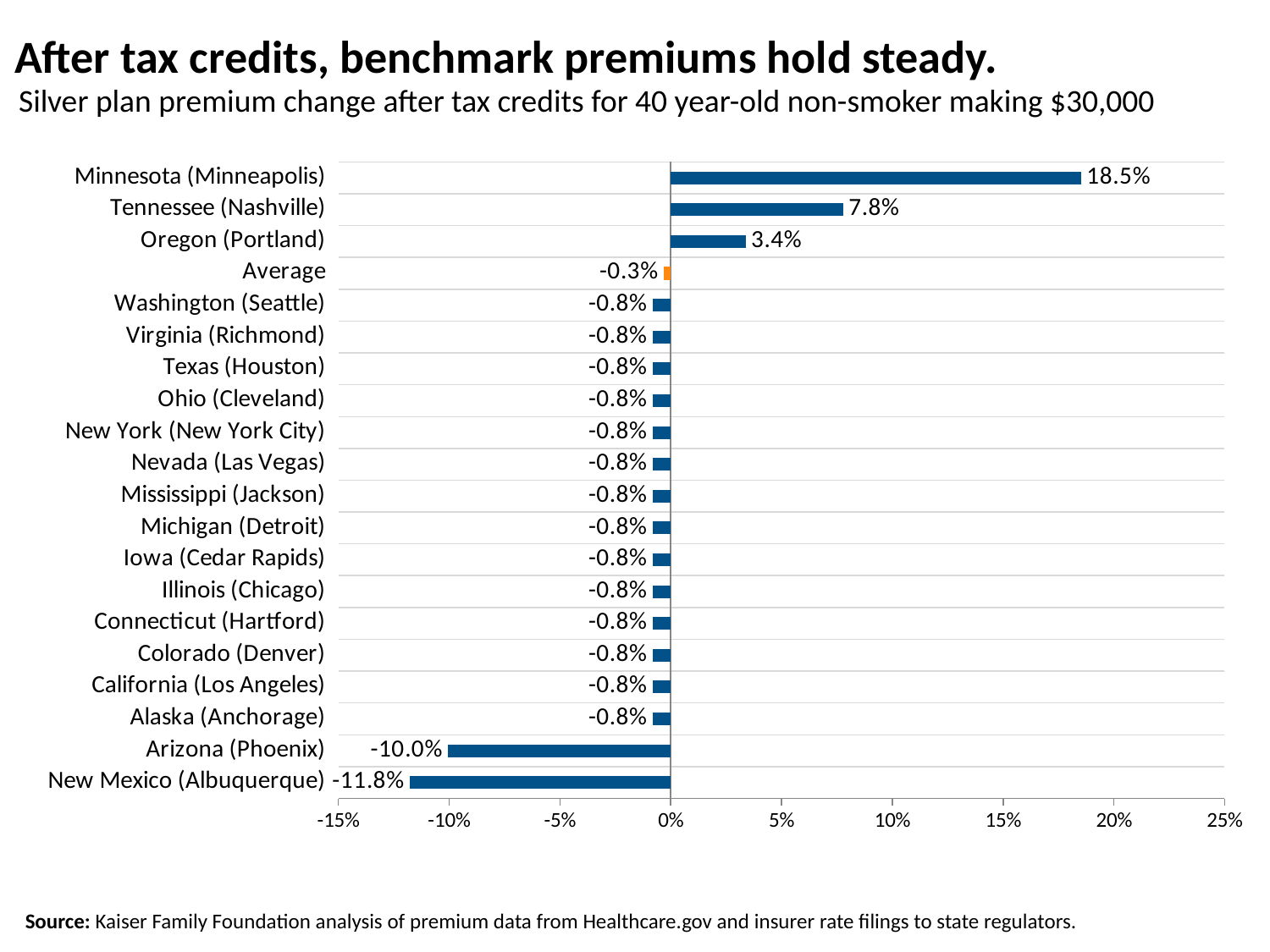
What type of chart is shown on the slide? Bar chart What is the premium change shown for Minnesota (Minneapolis)? 18.5% What is the premium change shown for Oregon (Portland)? 3.4% Which has a larger premium change, Tennessee (Nashville) or Oregon (Portland)? Tennessee (Nashville) How many bars are plotted on the chart, including the Average? 20 Which category has the highest premium change? Minnesota (Minneapolis) Which category has the lowest premium change? New Mexico (Albuquerque) Which bar is coloured orange rather than blue? Average What is the premium change shown for Washington (Seattle)? -0.8% What is the premium change shown for Arizona (Phoenix)? -10.0% What is the difference in percentage points between the premium change for Minnesota (Minneapolis) and Tennessee (Nashville)? 10.7 percentage points What is the Average premium change shown on the chart? -0.3%